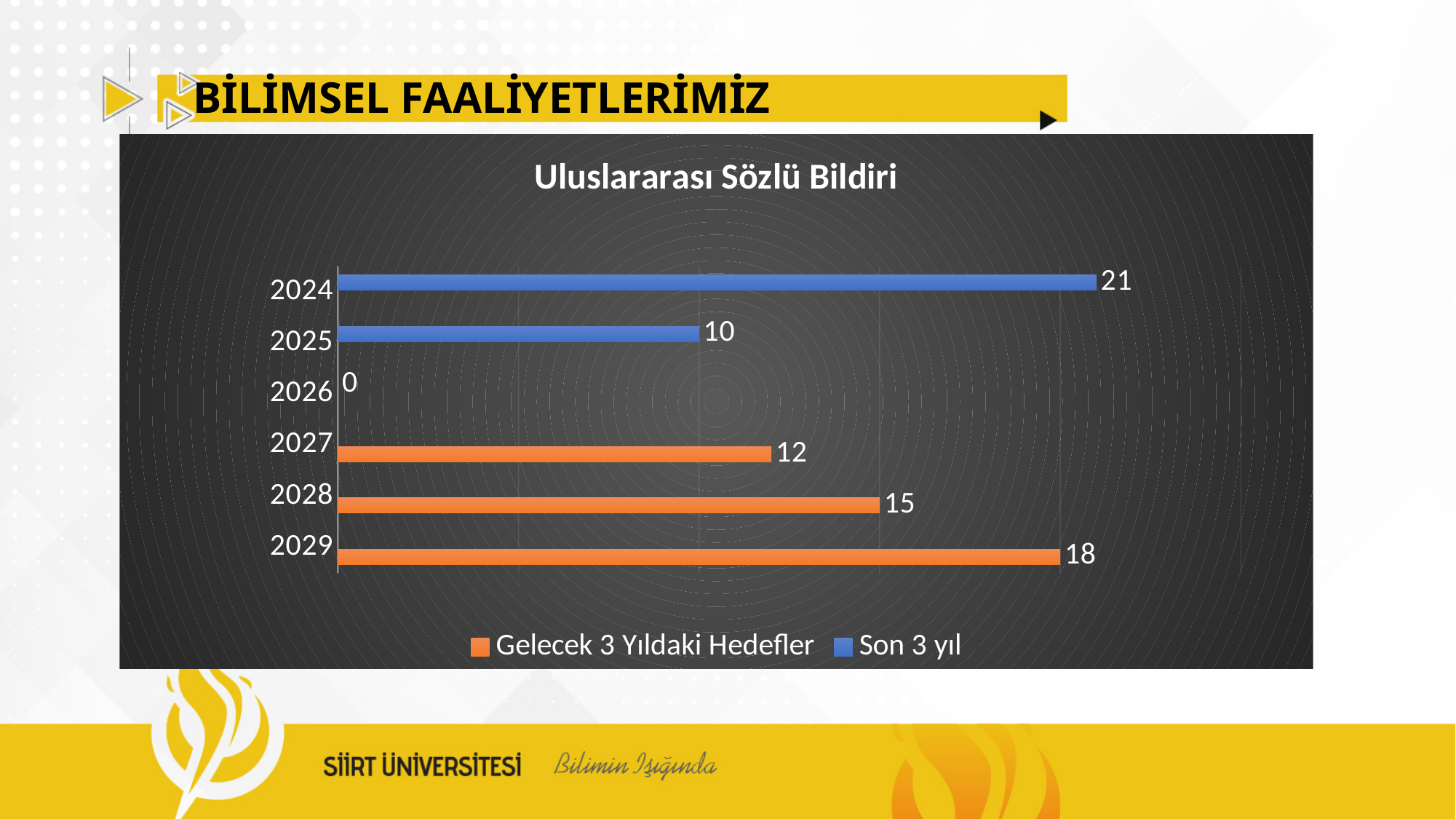
Which year has the highest value? 2024 How many years are shown on the chart? 6 What is the value for 2024 in the Uluslararası Sözlü Bildiri chart? 21 Which year has the lowest value? 2026 What is the difference between the values for 2029 and 2027? 6 Which is larger, the value for 2028 or the value for 2029? 2029 How many series does the legend list? 2 What type of chart is shown? Bar chart What is the value for 2026? 0 What is the difference between the values for 2024 and 2025? 11 What is the value for 2028? 15 What is the value for 2025? 10